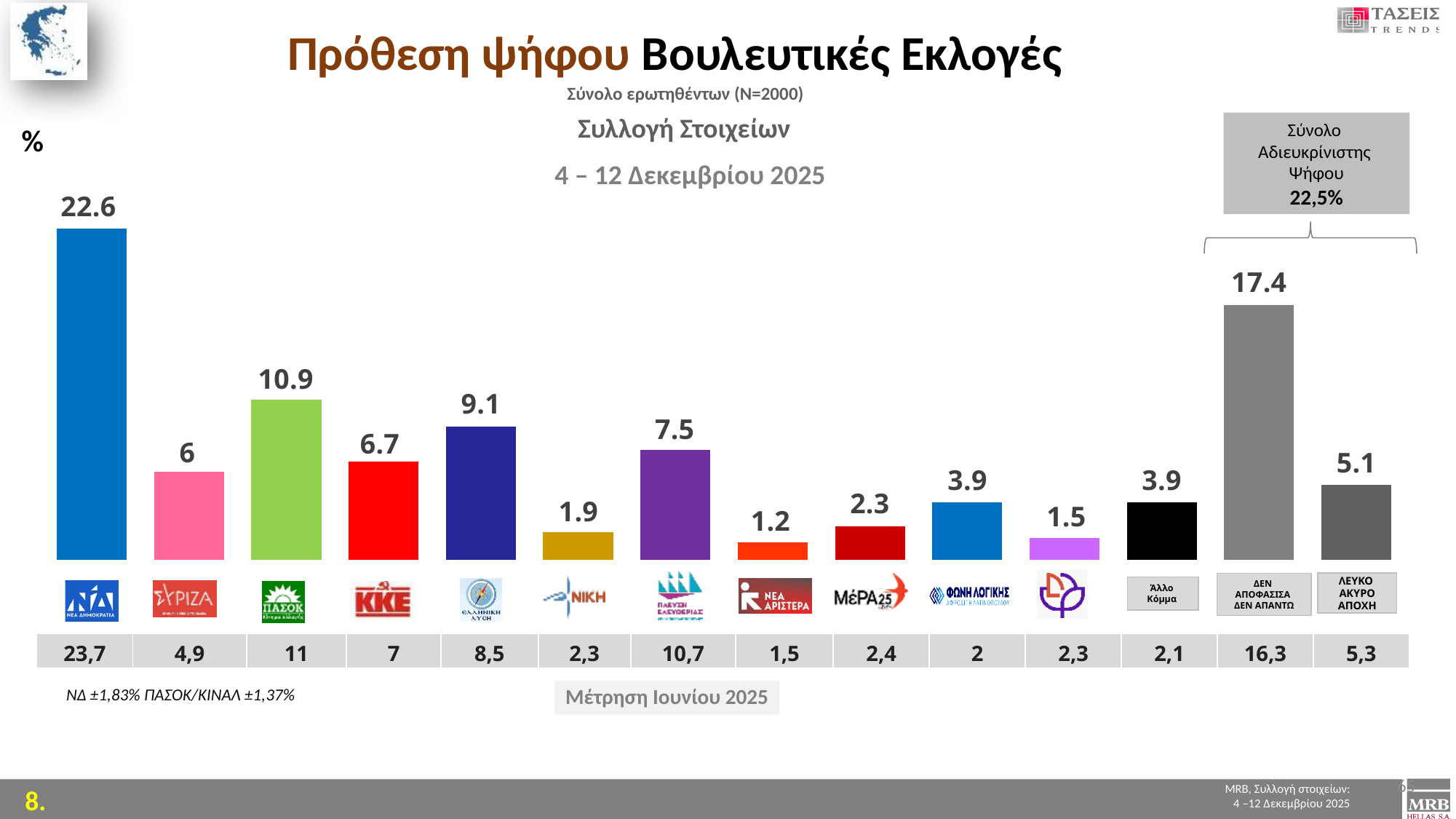
What type of chart is shown on the slide? bar chart Which category has the lowest value in the chart? ΝΕΑ ΑΡΙΣΤΕΡΑ What is the value shown for ΠΛΕΥΣΗ ΕΛΕΥΘΕΡΙΑΣ? 7.5 What is the value shown for ΔΕΝ ΑΠΟΦΑΣΙΣΑ / ΔΕΝ ΑΠΑΝΤΩ? 17.4 What is the sample size (N) stated under the chart title? N=2000 How many bars are plotted in the chart? 14 In the June 2025 measurement row (Μέτρηση Ιουνίου 2025), what value is shown for ΝΕΑ ΔΗΜΟΚΡΑΤΙΑ? 23,7 What is the vote intention value shown for ΠΑΣΟΚ in the December 2025 measurement? 10.9 Which has the larger value, ΚΚΕ or ΣΥΡΙΖΑ? ΚΚΕ What is the total of the undecided vote (Σύνολο Αδιευκρίνιστης Ψήφου) shown in the box above the chart? 22,5% Which party has the highest vote intention value in the chart? ΝΕΑ ΔΗΜΟΚΡΑΤΙΑ What is the difference between the values for ΝΕΑ ΔΗΜΟΚΡΑΤΙΑ and ΠΑΣΟΚ? 11.7